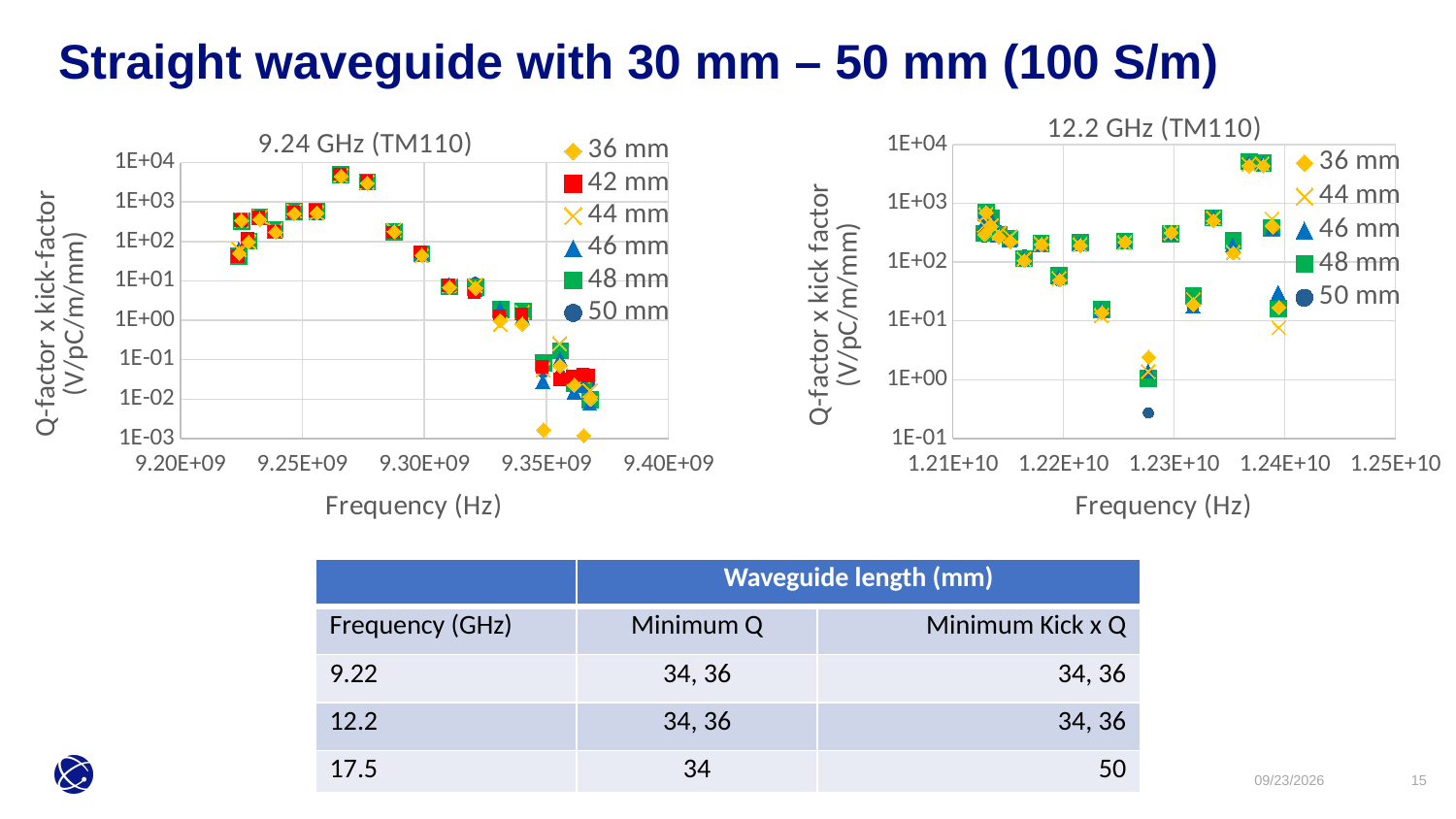
In the left chart (9.24 GHz (TM110)), is the highest plotted value greater or less than 1E+03? greater In the right chart (12.2 GHz (TM110)), is the 50 mm point near 1.23E+10 Hz greater or less than 1E+00? less How many series does the legend of the right chart (12.2 GHz (TM110)) list? 5 In the left chart (9.24 GHz (TM110)), is the lowest plotted value greater or less than 1E-02? less What is the title of the right chart? 12.2 GHz (TM110) In the right chart (12.2 GHz (TM110)), which series is drawn with a blue circle marker? 50 mm What kind of chart is the left chart titled 9.24 GHz (TM110)? scatter chart How many series does the legend of the left chart (9.24 GHz (TM110)) list? 6 In the left chart (9.24 GHz (TM110)), do the values generally rise or fall as frequency increases from 9.30E+09 to 9.40E+09? fall